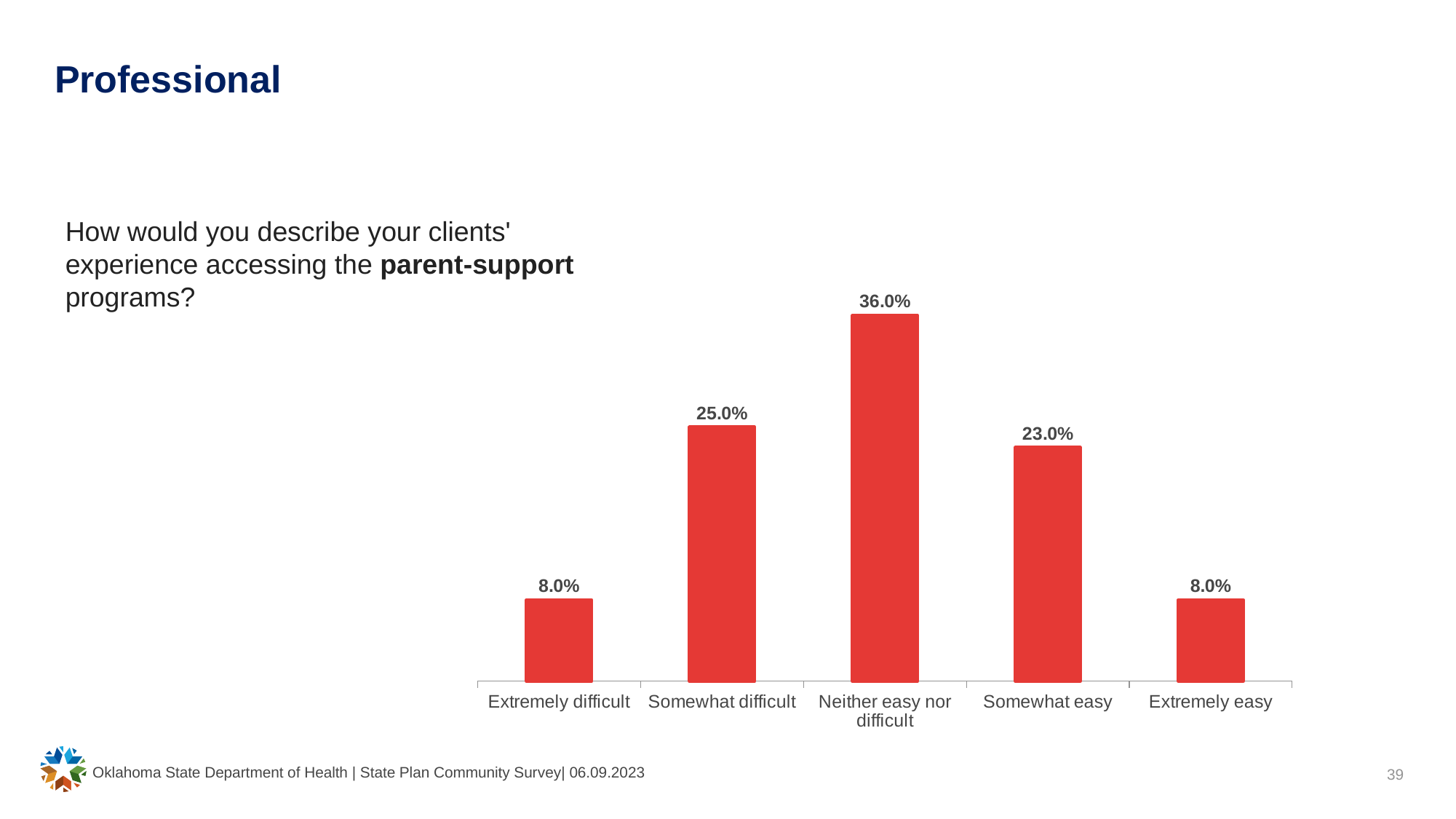
What is the value shown for "Somewhat easy"? 23.0% How many categories are shown on the x axis of the chart? 5 What percentage of respondents described their clients' experience accessing parent-support programs as "Somewhat difficult"? 25.0% What is the difference between the values for "Somewhat easy" and "Extremely easy"? 15.0% What colour are the bars in the chart? Red What is the value shown for "Neither easy nor difficult"? 36.0% Which category has the highest value? Neither easy nor difficult Do the values for "Extremely difficult" and "Extremely easy" differ, or are they the same? The same What is the value shown for "Extremely easy"? 8.0% What is the difference between the values for "Neither easy nor difficult" and "Somewhat difficult"? 11.0% Which is larger, the value for "Somewhat difficult" or the value for "Somewhat easy"? Somewhat difficult What kind of chart is shown on the slide? Bar chart